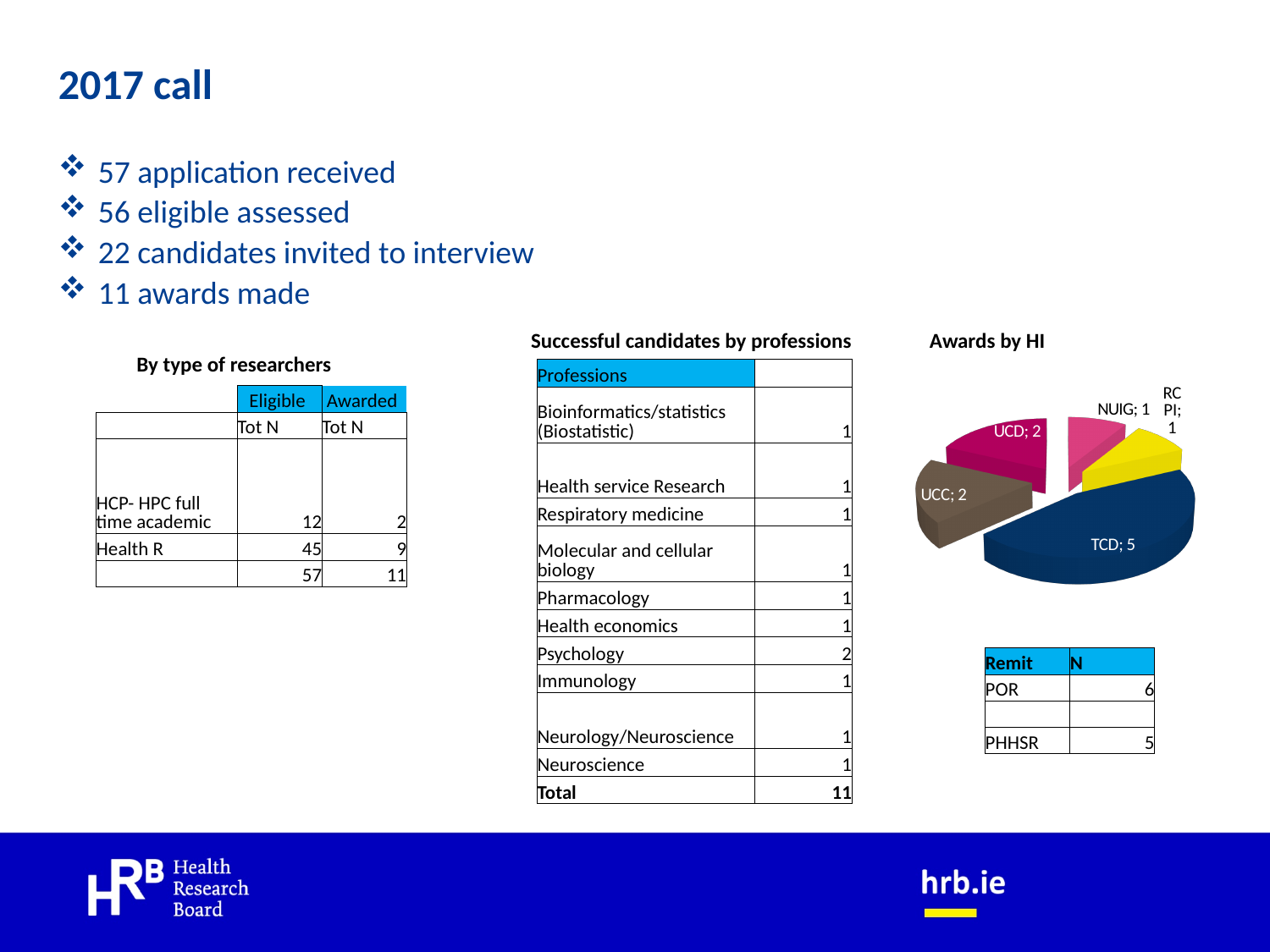
What is the title of the pie chart on the slide? Awards by HI In the 'Awards by HI' chart, how many awards does UCD have? 2 In the 'Awards by HI' chart, how many awards does RC PI have? 1 In the 'Awards by HI' chart, which institution has the largest slice? TCD In the 'Awards by HI' chart, how many awards does UCC have? 2 In the 'Awards by HI' chart, what is the total number of awards across all slices? 11 In the 'Awards by HI' chart, how many slices (institutions) are shown? 5 In the 'Awards by HI' chart, how many awards does TCD have? 5 In the 'Awards by HI' chart, which has more awards, TCD or UCD? TCD What kind of chart is the 'Awards by HI' chart? pie chart In the 'Awards by HI' chart, how many awards does NUIG have? 1 In the 'Awards by HI' chart, what is the difference between the awards for TCD and UCC? 3